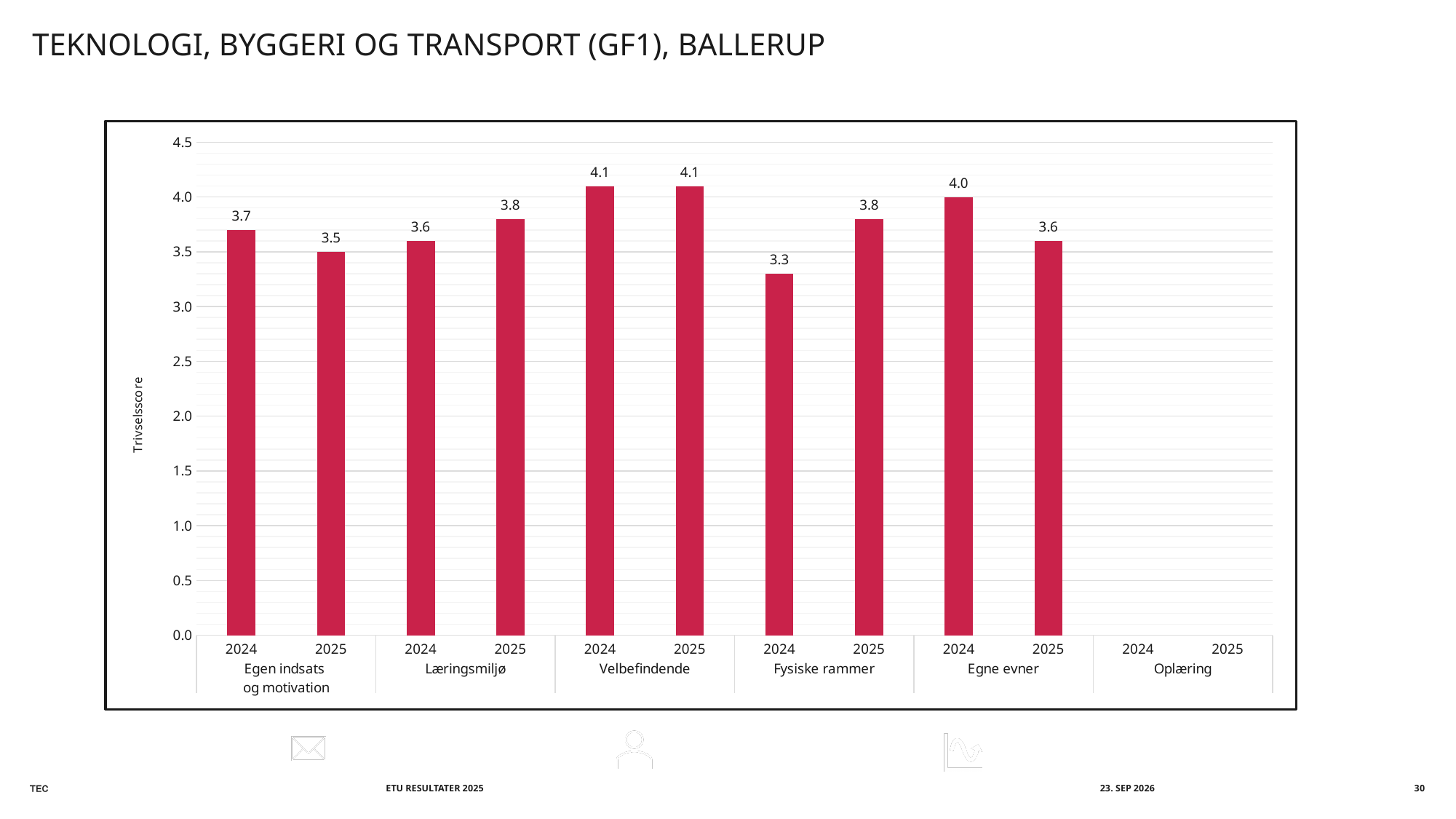
What is the difference between the 2024 and 2025 Trivselsscore for Fysiske rammer? 0.5 What is the difference between the 2024 and 2025 Trivselsscore for Egne evner? 0.4 Did the Trivselsscore for Egen indsats og motivation rise or fall from 2024 to 2025? Fall Which category and year has the lowest Trivselsscore shown? Fysiske rammer, 2024 What is the Trivselsscore for Egne evner in 2024? 4.0 What is the label of the vertical axis? Trivselsscore What kind of chart is shown on the slide? Bar chart Which is larger for Læringsmiljø, the 2024 or the 2025 Trivselsscore? 2025 What is the Trivselsscore for Fysiske rammer in 2025? 3.8 What is the Trivselsscore for Egen indsats og motivation in 2024? 3.7 How many category groups are shown on the x axis? 6 Is the 2024 Trivselsscore for Velbefindende greater or less than 4.0? greater